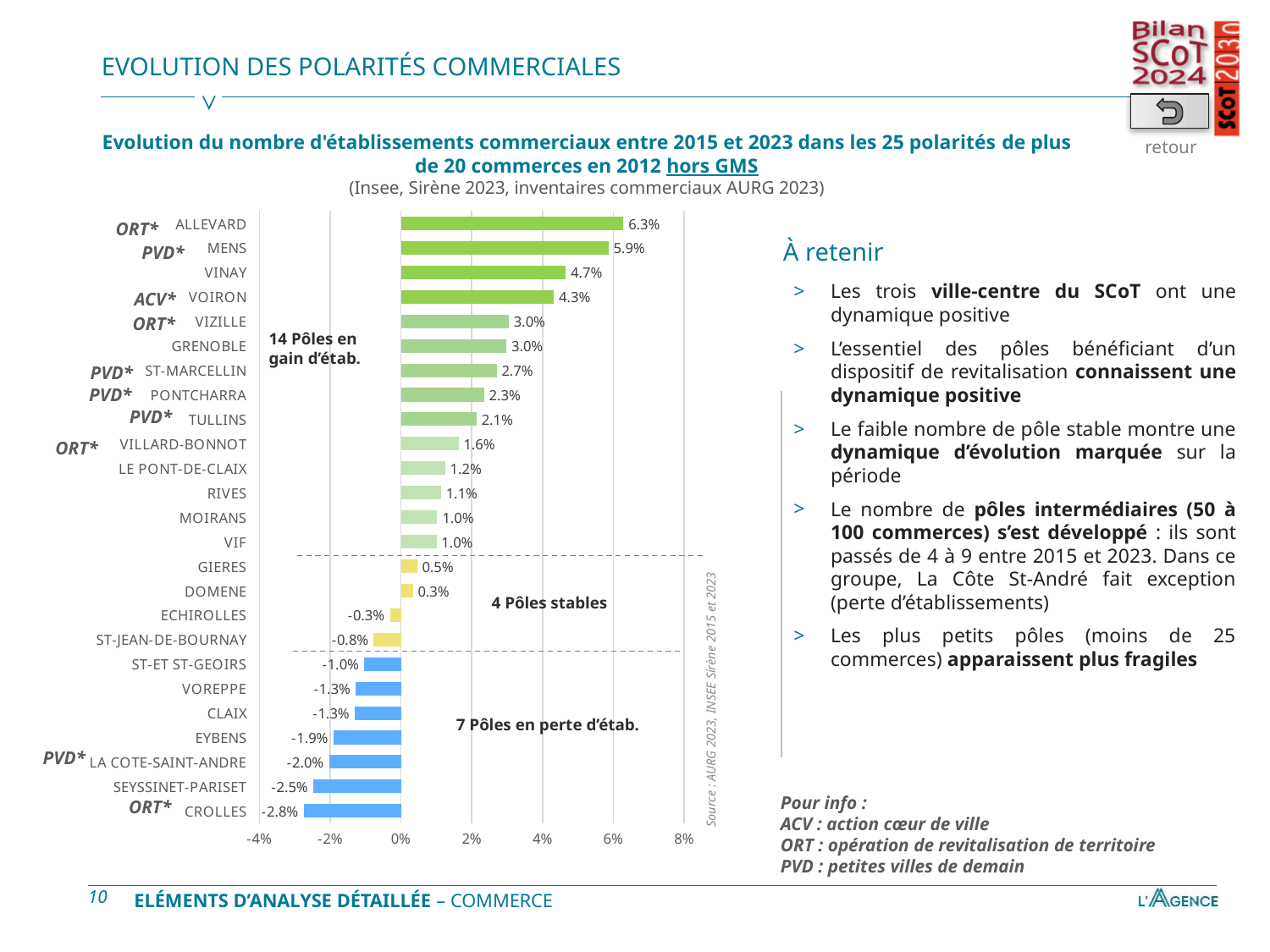
What is the difference between the values for ALLEVARD and MENS? 0.4% According to the chart annotation, how many pôles are in loss of establishments (perte d'étab.)? 7 Which category has the lowest value? CROLLES What is the difference between the values for VINAY and VIZILLE? 1.7% What type of chart is shown on the slide? bar chart Which category has the highest value? ALLEVARD What is the value for ALLEVARD? 6.3% What is the value for VOIRON? 4.3% How many categories are plotted in the chart? 25 What is the value for CROLLES? -2.8% What is the value for LA COTE-SAINT-ANDRE? -2.0% Which has the larger value, PONTCHARRA or TULLINS? PONTCHARRA